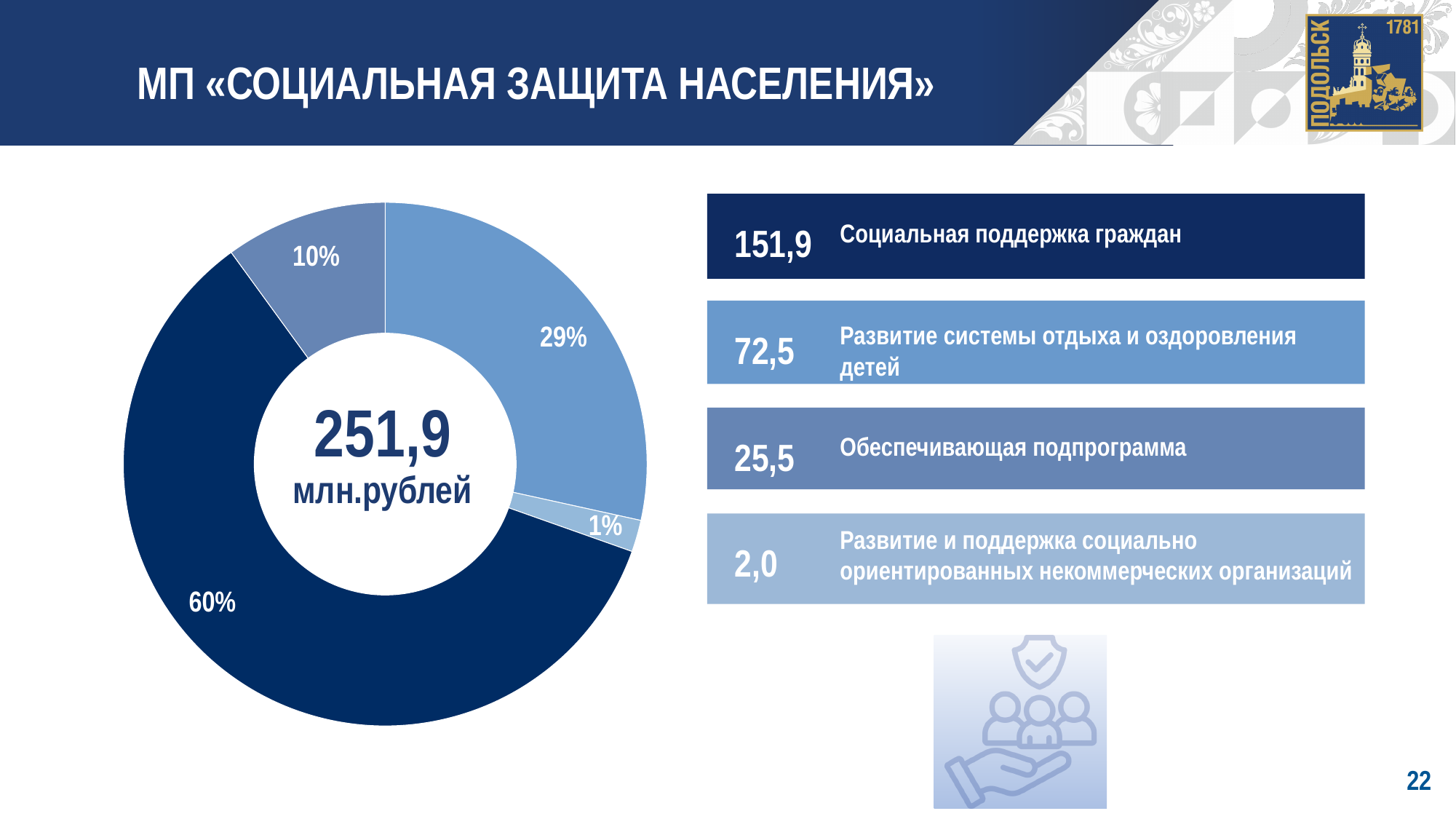
Which subprogramme has the highest value in the list next to the chart? Социальная поддержка граждан What share of the donut chart does the largest slice take? 60% How many slices does the donut chart have? 4 What is the value shown for «Обеспечивающая подпрограмма»? 25,5 What is the difference between the values for «Социальная поддержка граждан» and «Развитие системы отдыха и оздоровления детей»? 79,4 Which is larger: the value for «Обеспечивающая подпрограмма» or for «Развитие и поддержка социально ориентированных некоммерческих организаций»? Обеспечивающая подпрограмма Which subprogramme has the lowest value in the list next to the chart? Развитие и поддержка социально ориентированных некоммерческих организаций What is the title of the slide containing the donut chart? МП «СОЦИАЛЬНАЯ ЗАЩИТА НАСЕЛЕНИЯ» What share of the donut chart does the smallest slice take? 1% What kind of chart is shown on the slide? Pie chart (donut) What total value is shown in the centre of the donut chart? 251,9 млн.рублей What is the value shown for «Развитие системы отдыха и оздоровления детей»? 72,5